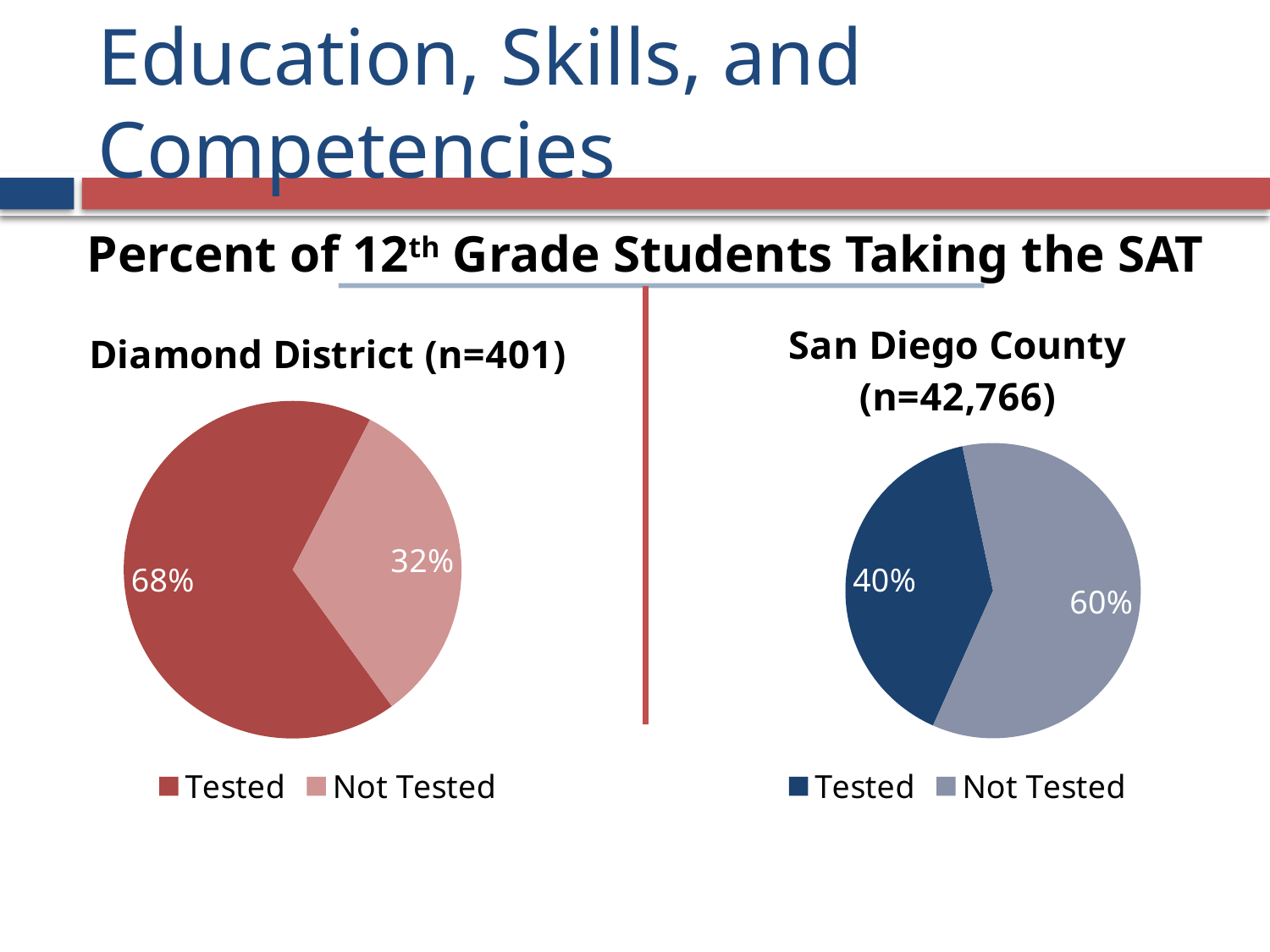
In the San Diego County (n=42,766) pie chart, what percentage of students were Not Tested? 60% In the Diamond District (n=401) pie chart, what percentage of students were Tested? 68% How many slices does the San Diego County (n=42,766) pie chart have? 2 How many entries does the legend of the Diamond District (n=401) pie chart list? 2 In the San Diego County (n=42,766) pie chart, which slice is the smallest? Tested In the Diamond District (n=401) pie chart, what is the difference between the Tested and Not Tested percentages? 36% Which chart shows a larger Tested share, Diamond District (n=401) or San Diego County (n=42,766)? Diamond District (n=401) What type of chart is used for the Diamond District (n=401) data? Pie chart In the Diamond District (n=401) pie chart, what percentage of students were Not Tested? 32% In the San Diego County (n=42,766) pie chart, what is the difference between the Not Tested and Tested percentages? 20% In the Diamond District (n=401) pie chart, which slice is the largest? Tested In the San Diego County (n=42,766) pie chart, what percentage of students were Tested? 40%